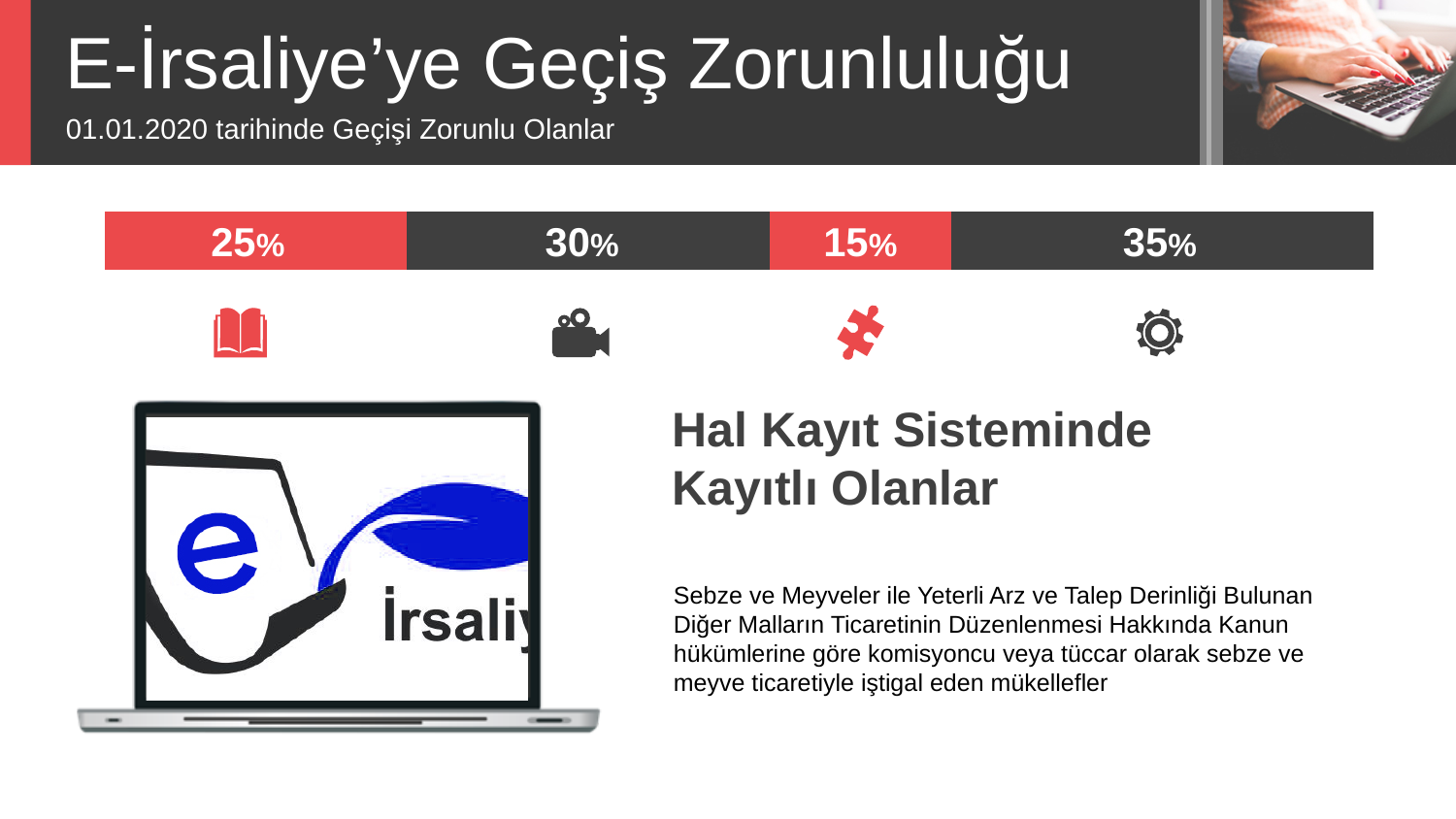
What is the value shown in the second segment of the bar? 30% How many segments does the bar contain? 4 What is the difference between the second segment (30%) and the first segment (25%)? 5% What kind of chart is shown on the slide? A horizontal stacked bar chart What colour are the 25% and 15% segments of the bar? Red What is the value shown in the fourth (rightmost) segment of the bar? 35% Which segment of the bar has the lowest value? The third segment, 15% Which is larger, the first segment or the second segment of the bar? The second segment (30%) What is the value shown in the third segment of the bar? 15% What is the value shown in the first (leftmost) segment of the bar? 25% What is the difference between the largest segment (35%) and the smallest segment (15%)? 20% Which segment of the bar has the highest value? The fourth (rightmost) segment, 35%